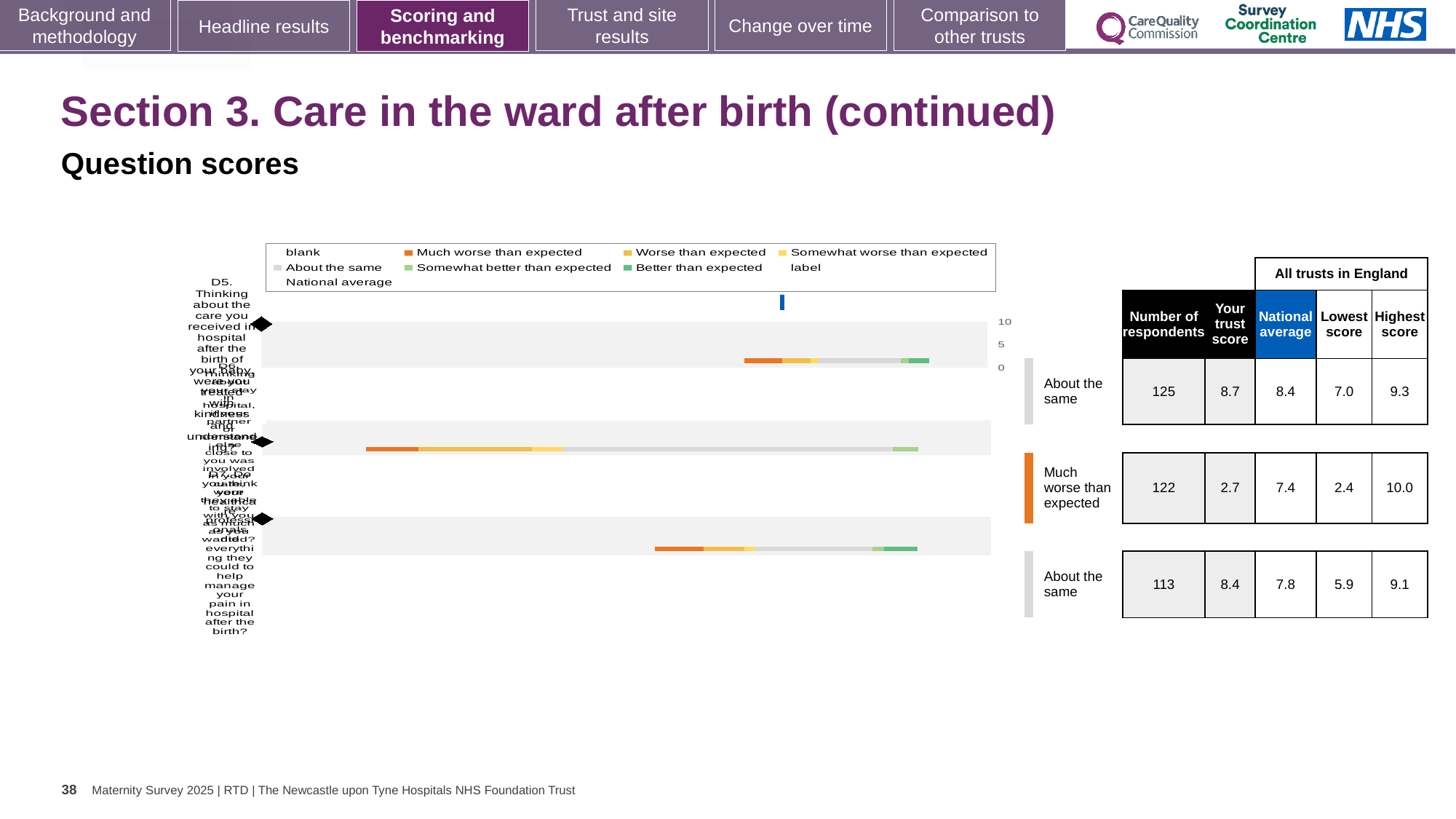
What is the difference between the trust score and the national average for the middle row rated 'Much worse than expected'? 4.7 What kind of chart is shown on the slide? bar chart Is the trust score for the top row (8.7) larger or smaller than its national average (8.4)? larger What is the highest score among all trusts in England for the middle row rated 'Much worse than expected'? 10.0 What is the trust score for the top row of the chart (the question rated 'About the same' with 125 respondents)? 8.7 What is the trust score for the middle row of the chart, rated 'Much worse than expected'? 2.7 In the chart legend, which colour represents 'Much worse than expected'? orange What is the national average for the bottom row of the chart (113 respondents)? 7.8 How many bars (question rows) are plotted in the chart? 3 What is the highest value shown on the chart's axis? 10 How many respondents answered the question in the bottom row of the chart? 113 Which row of the chart has the lowest trust score? the middle row (Much worse than expected)